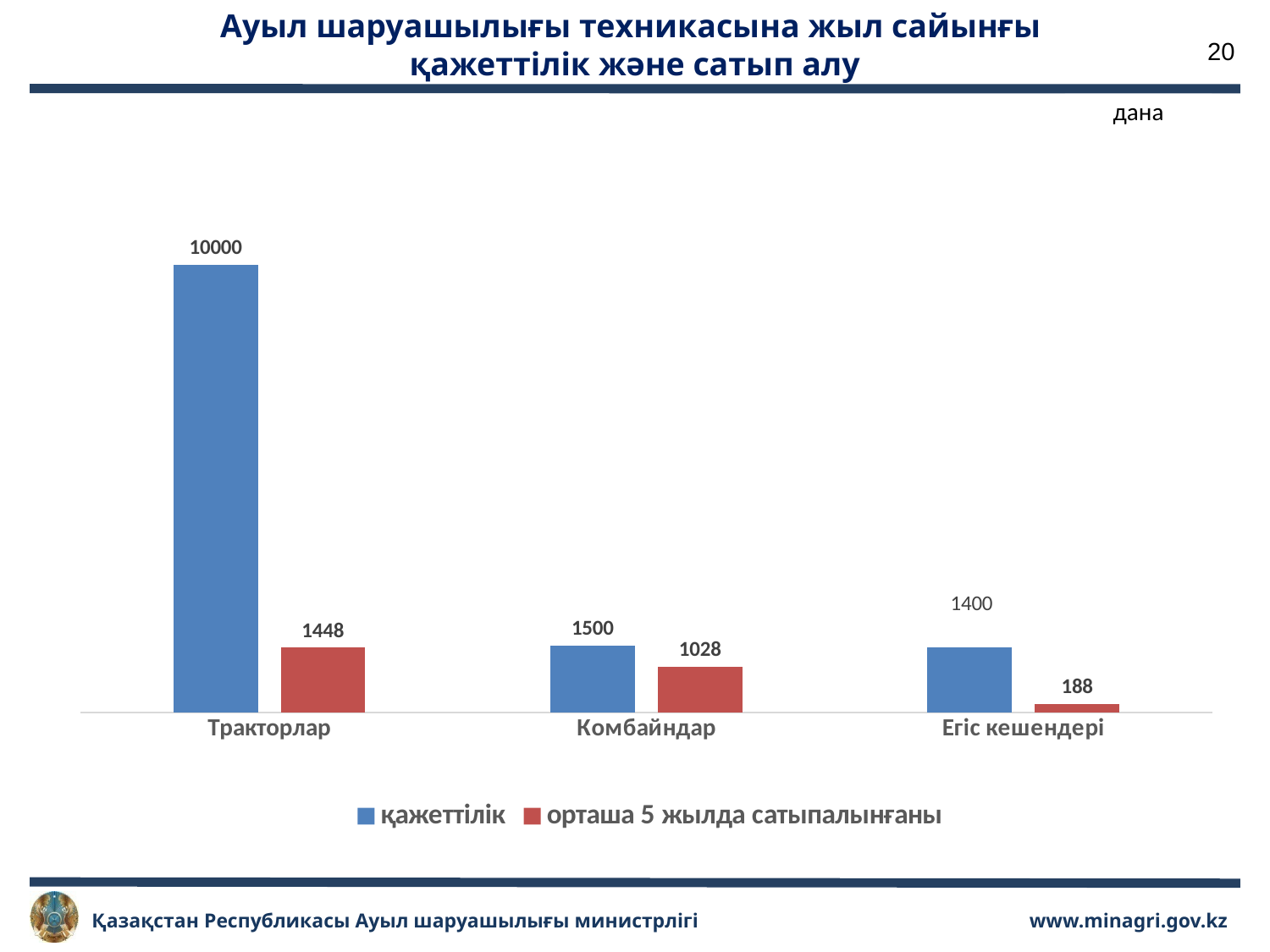
What is the value of орташа 5 жылда сатыпалынғаны for Комбайндар? 1028 What is the value of орташа 5 жылда сатыпалынғаны for Егіс кешендері? 188 What kind of chart is shown on the slide? Bar chart What is the difference between қажеттілік and орташа 5 жылда сатыпалынғаны for Тракторлар? 8552 Which category has the highest қажеттілік value? Тракторлар What is the value of қажеттілік for Тракторлар? 10000 Which category has the lowest орташа 5 жылда сатыпалынғаны value? Егіс кешендері How many series does the legend list? 2 What is the value of қажеттілік for Егіс кешендері? 1400 What is the difference between қажеттілік and орташа 5 жылда сатыпалынғаны for Комбайндар? 472 How many categories are shown on the x axis? 3 Which is larger: орташа 5 жылда сатыпалынғаны for Тракторлар or for Комбайндар? Тракторлар